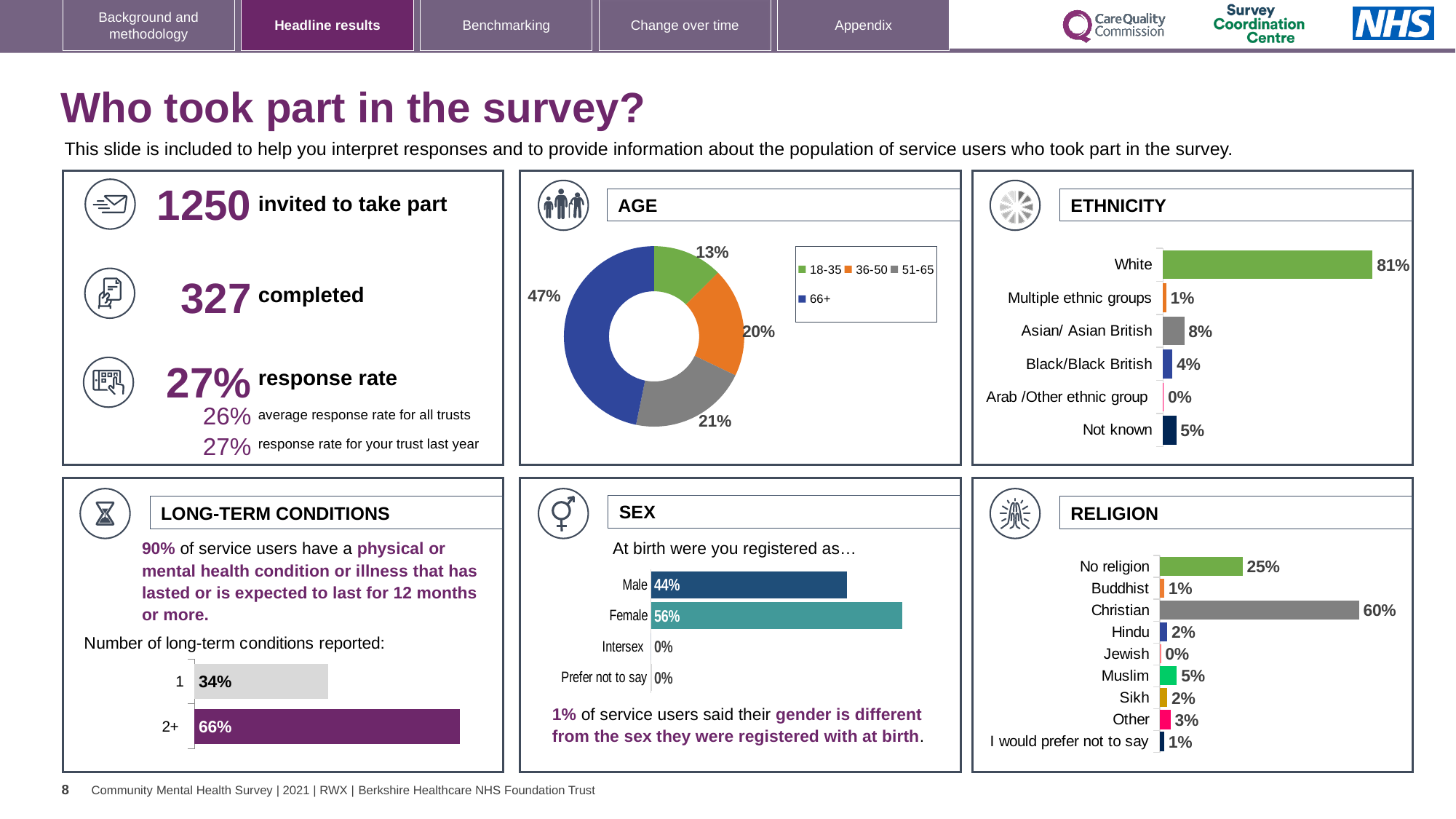
What kind of chart is the AGE chart? Doughnut chart In the SEX chart, what is the value for Female? 56% In the AGE chart, what percentage of respondents were aged 66+? 47% How many series does the legend of the AGE chart list? 4 In the RELIGION chart, what is the value for Christian? 60% In the LONG-TERM CONDITIONS chart, what is the difference between the 2+ and 1 categories? 32% In the ETHNICITY chart, what is the value for Asian/ Asian British? 8% In the SEX chart, which is larger, Male or Female? Female In the ETHNICITY chart, what is the difference between White and Not known? 76% How many categories are shown in the ETHNICITY chart? 6 In the AGE chart, which age group has the smallest share? 18-35 In the ETHNICITY chart, which category has the highest value? White